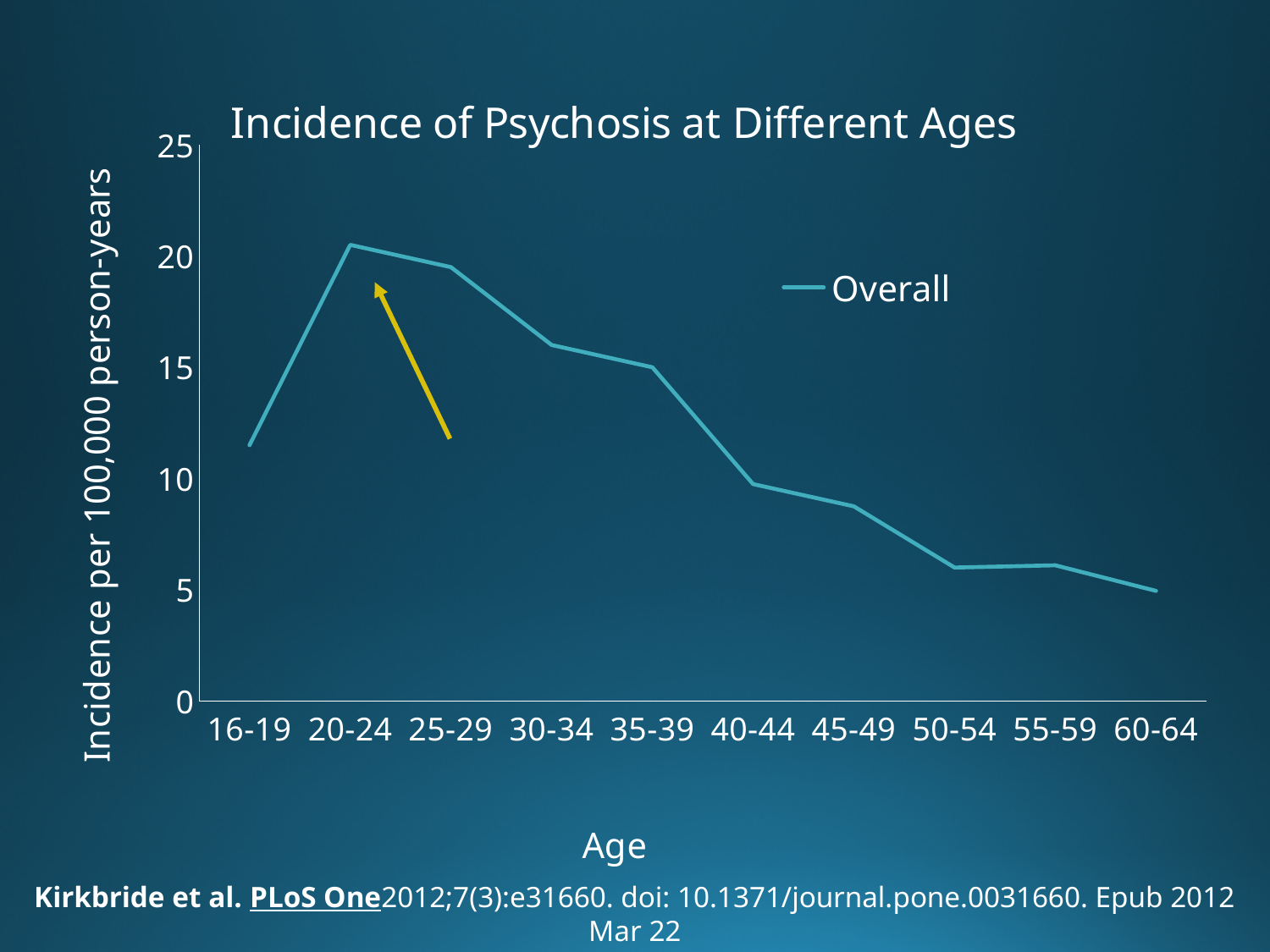
What series name does the legend show? Overall Which age group has the lowest incidence of psychosis? 60-64 Is the incidence for the 45-49 age group greater or less than 10? less What kind of chart is shown on the slide? line chart Is the incidence for the 16-19 age group greater or less than 10? greater Is the incidence for the 16-19 age group greater or less than 15? less What is the title of the chart? Incidence of Psychosis at Different Ages How many series does the legend list? 1 Which age group has the highest incidence of psychosis? 20-24 Which age group has a higher incidence, 30-34 or 45-49? 30-34 From the 20-24 age group onward, does the incidence rise or fall with increasing age? fall How many age groups are plotted along the x axis? 10